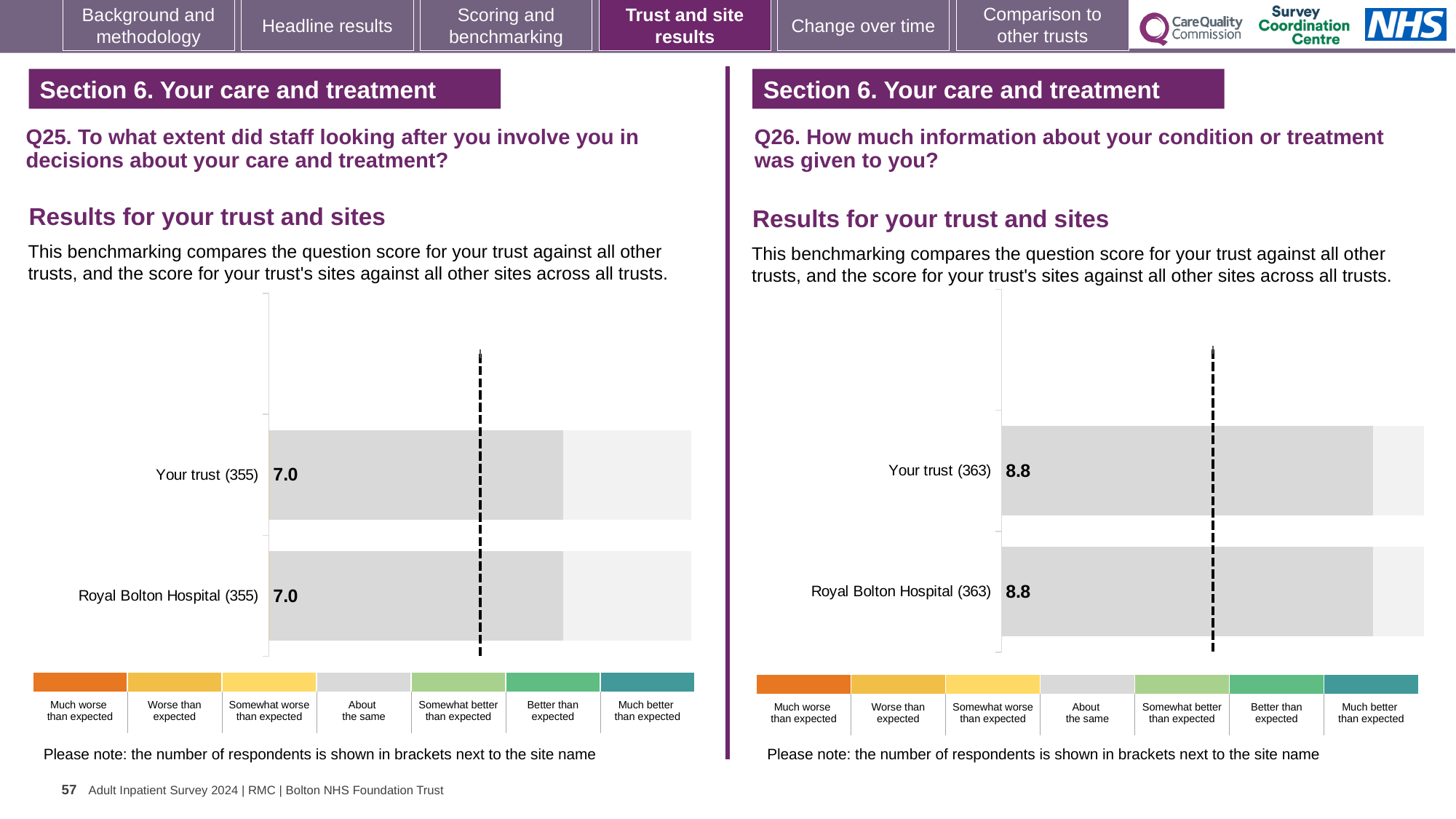
Is the score for Your trust on the Q26 chart (right) larger than the score for Your trust on the Q25 chart (left)? Yes How many categories does the colour key below the Q26 chart (right) list? 7 On the Q25 chart (left), which category does the Your trust bar fall into according to the colour key? About the same On the Q25 chart (left), how many respondents are shown in brackets next to Your trust? 355 On the Q26 chart (right), how many bars are plotted? 2 On the Q26 chart (right), what is the score for Your trust? 8.8 On the Q25 chart (left), what is the difference between the score for Your trust and the score for Royal Bolton Hospital? 0.0 On the Q26 chart (right), what is the score for Royal Bolton Hospital? 8.8 On the Q26 chart (right), how many respondents are shown in brackets next to Royal Bolton Hospital? 363 What kind of chart is used on the Q25 chart (left)? Bar chart On the Q25 chart (left), what is the score for Your trust? 7.0 On the Q25 chart (left), what is the score for Royal Bolton Hospital? 7.0